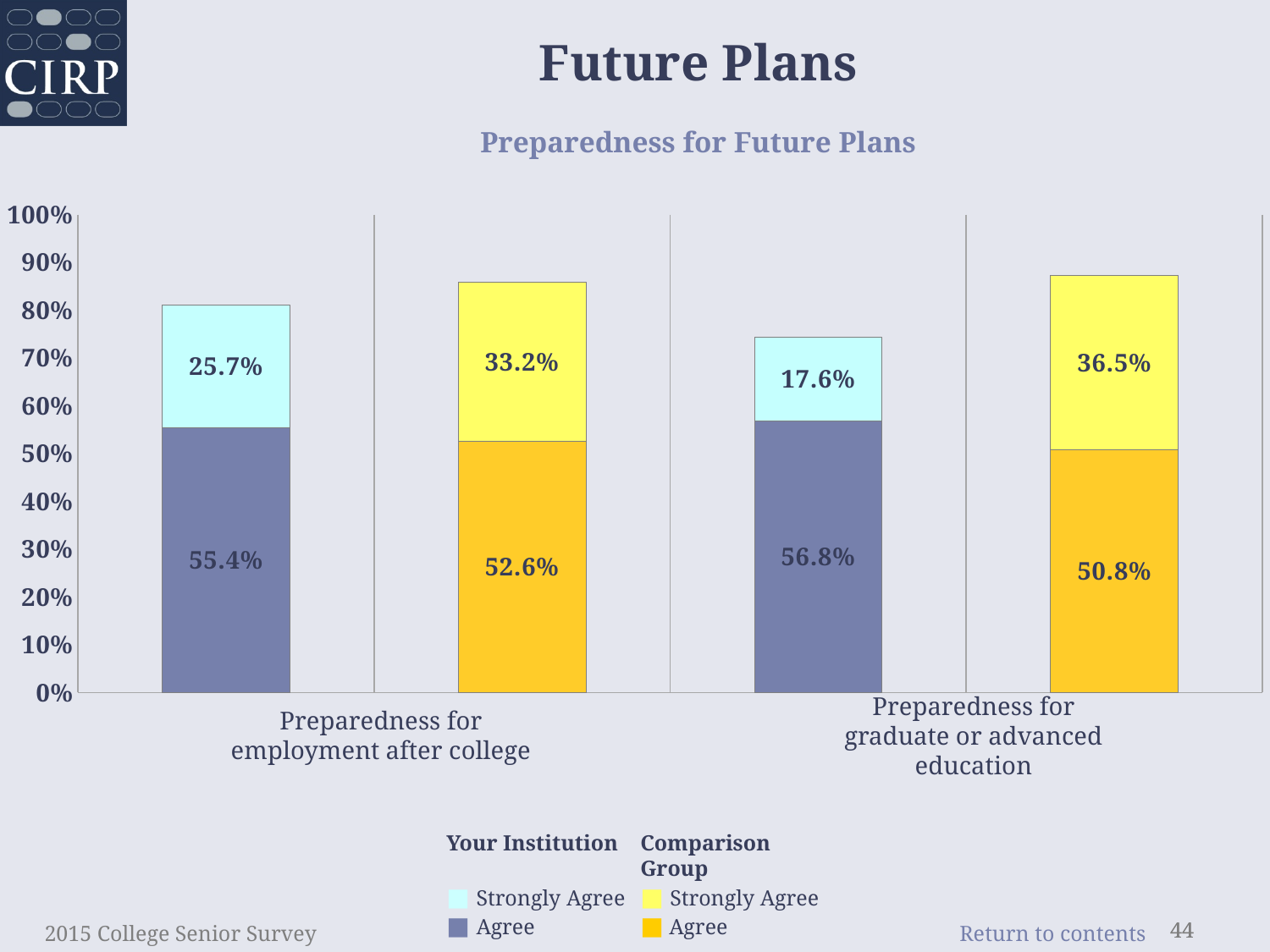
What is the subtitle of the chart? Preparedness for Future Plans How many entries does the legend list? 4 Which is larger for preparedness for graduate or advanced education: the Your Institution Strongly Agree value or the Comparison Group Strongly Agree value? Comparison Group What is the total of the Comparison Group stacked bar for preparedness for graduate or advanced education? 87.3% Which Strongly Agree value is the lowest on the chart? 17.6% What percentage of Your Institution respondents strongly agree on preparedness for employment after college? 25.7% What is the Strongly Agree value for the Comparison Group on preparedness for graduate or advanced education? 36.5% What kind of chart is shown on the slide? Stacked bar chart What is the total of the Your Institution stacked bar for preparedness for employment after college? 81.1% What is the Agree value for Your Institution on preparedness for graduate or advanced education? 56.8% What is the difference between the Comparison Group and Your Institution Strongly Agree values for preparedness for employment after college? 7.5% What percentage of the Comparison Group agree on preparedness for graduate or advanced education? 50.8%